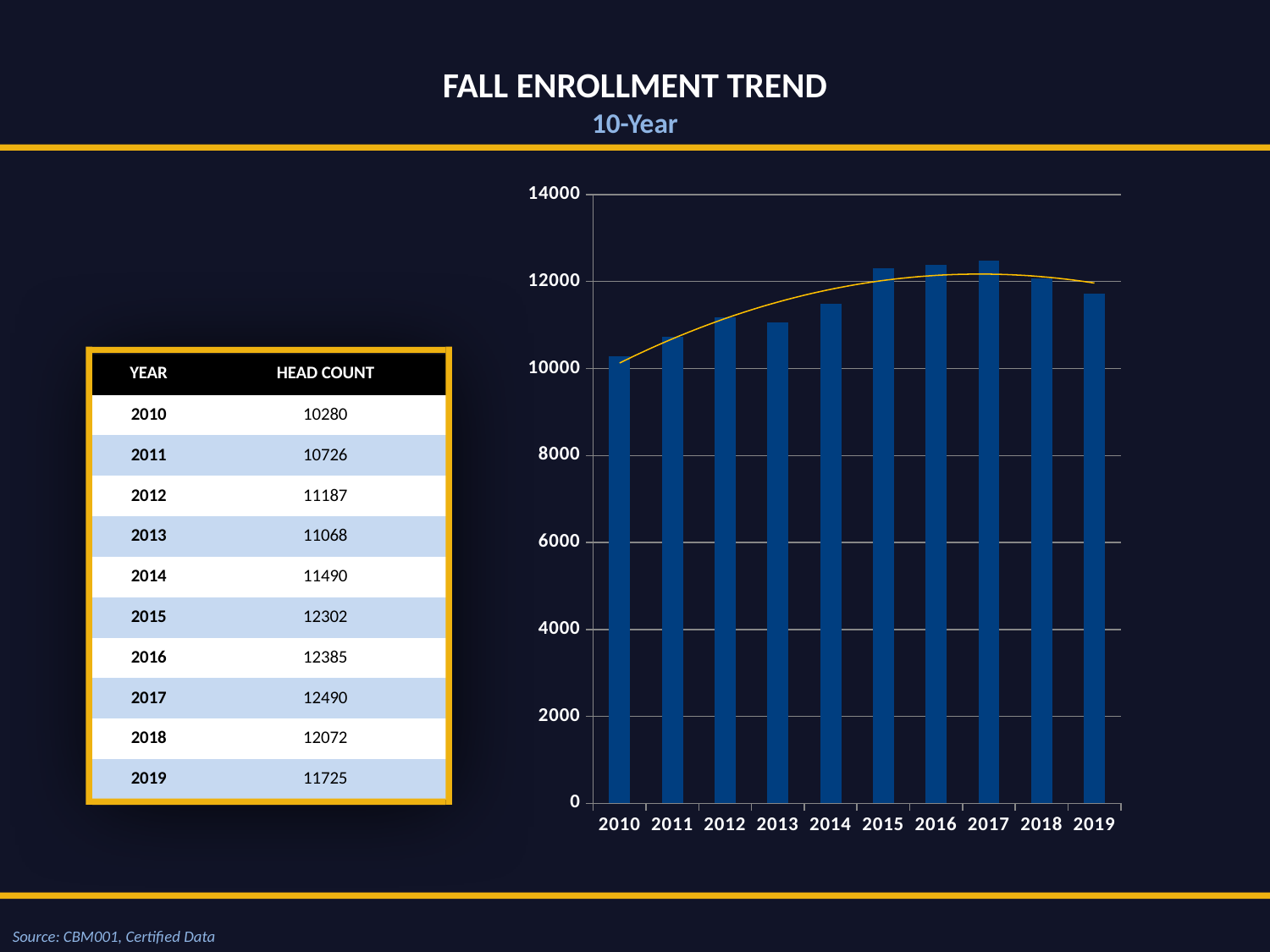
Is the head count for 2013 greater or less than 12000? less What is the head count for 2017? 12490 What is the difference in head count between 2017 and 2010? 2210 What is the head count for 2019? 11725 What kind of chart is shown on the slide? bar chart How many years are plotted on the x axis of the chart? 10 Which year has the highest head count? 2017 Which year has the larger head count, 2012 or 2013? 2012 What is the title of the slide containing the chart? FALL ENROLLMENT TREND What is the head count for 2010? 10280 Is the head count for 2015 greater or less than 12000? greater Which year has the lowest head count? 2010